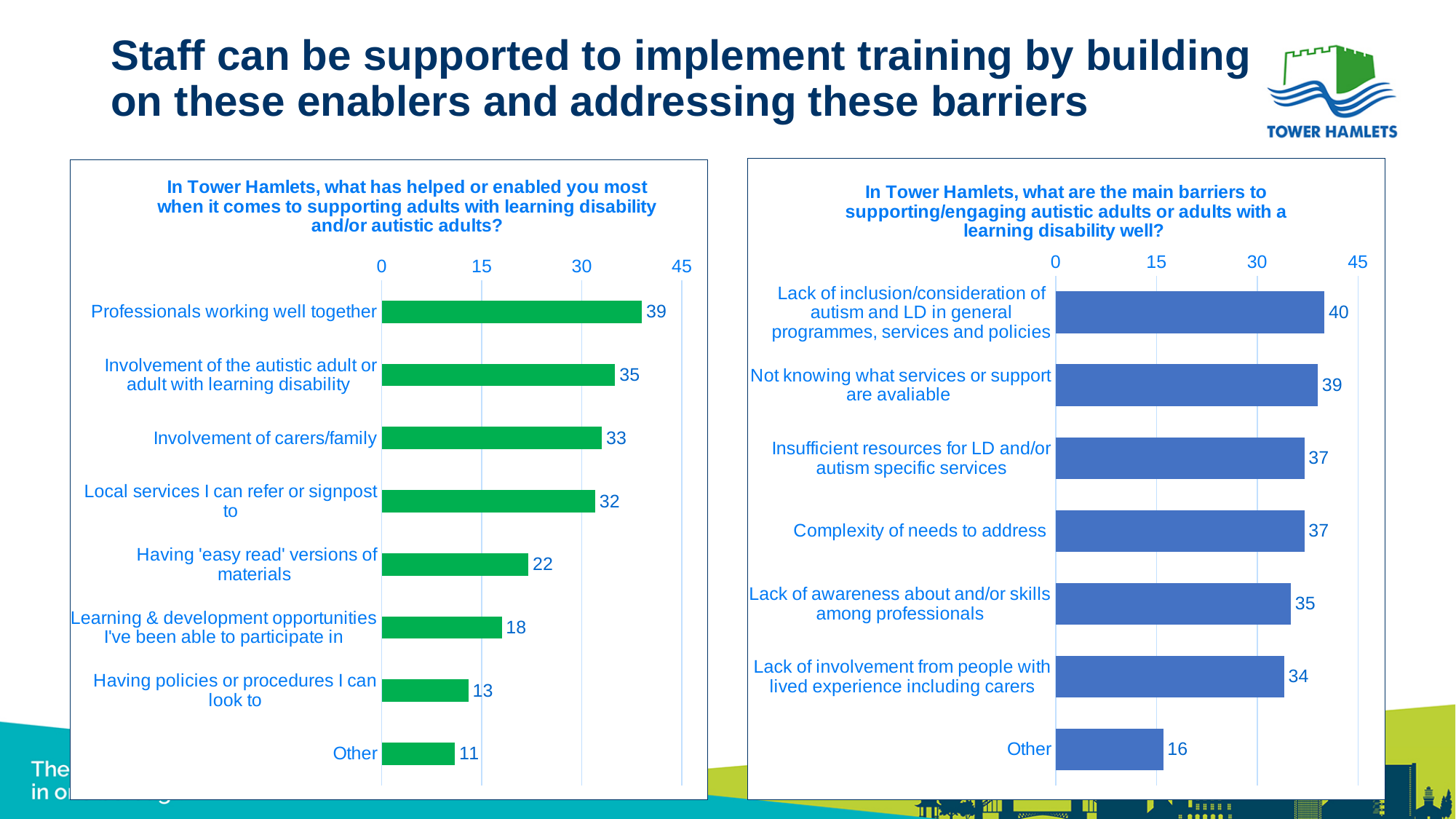
In the left chart (what has helped or enabled you most), what is the difference between 'Involvement of carers/family' and 'Having policies or procedures I can look to'? 20 In the left chart (what has helped or enabled you most), which category has the lowest value? Other In the left chart (what has helped or enabled you most), which is larger: 'Having 'easy read' versions of materials' or 'Learning & development opportunities I've been able to participate in'? Having 'easy read' versions of materials In the right chart (main barriers), is the value for 'Lack of awareness about and/or skills among professionals' greater or less than 30? greater In the right chart (main barriers), which category has the highest value? Lack of inclusion/consideration of autism and LD in general programmes, services and policies In the right chart (main barriers), what is the difference between 'Not knowing what services or support are avaliable' and 'Other'? 23 What colour are the bars in the left chart (what has helped or enabled you most)? Green In the left chart (what has helped or enabled you most), what is the value for 'Professionals working well together'? 39 What type of chart is the right chart (main barriers)? Bar chart How many categories are shown in the right chart (main barriers)? 7 How many categories are shown in the left chart (what has helped or enabled you most)? 8 In the right chart (main barriers), what is the value for 'Complexity of needs to address'? 37